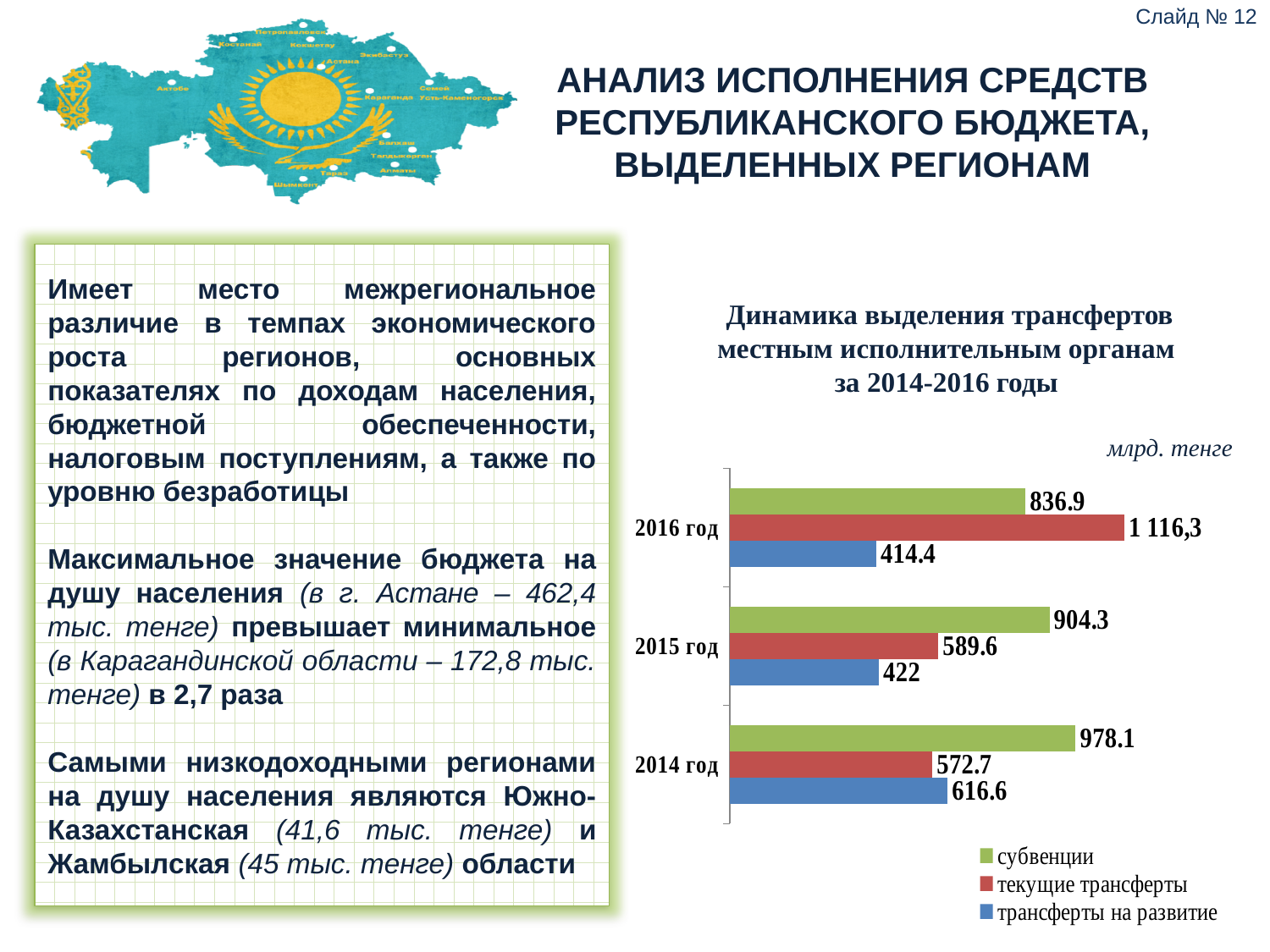
Which is larger for 2015 год: субвенции or текущие трансферты? субвенции What is the difference between субвенции in 2014 год and 2015 год? 73.8 How many years are shown on the chart? 3 Do субвенции rise or fall from 2014 год to 2016 год? fall In which year were трансферты на развитие the lowest? 2016 год What is the value of текущие трансферты for 2014 год? 572.7 What type of chart is shown on the slide? bar chart What is the value of текущие трансферты for 2016 год? 1 116,3 How many series does the legend list? 3 In which year were субвенции the highest? 2014 год What is the value of субвенции for 2016 год? 836.9 What is the value of трансферты на развитие for 2015 год? 422